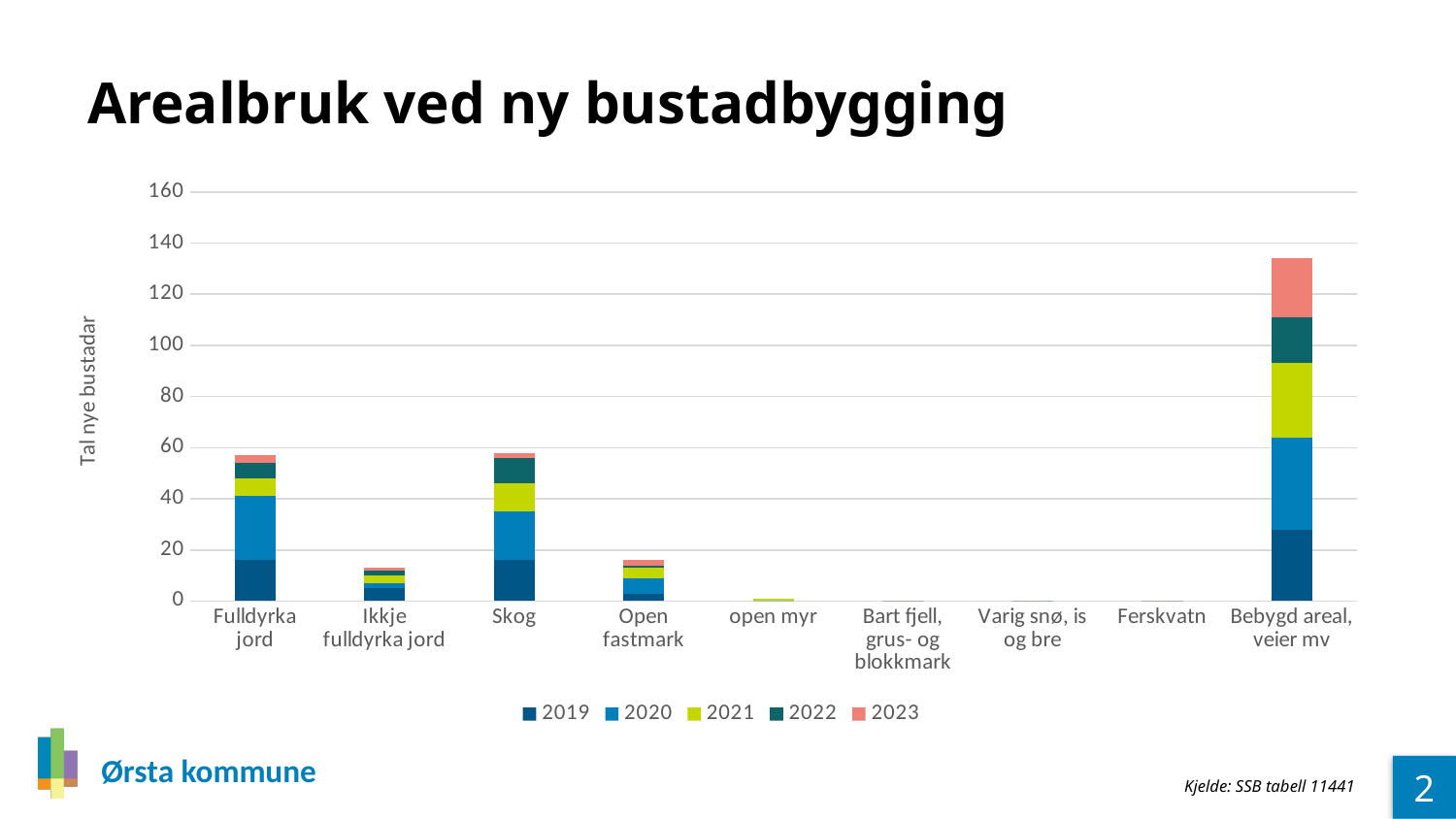
How many categories are shown on the x axis? 9 How many series does the legend list? 5 Is the total value for Skog greater or less than 40? greater What is the label on the vertical axis? Tal nye bustadar Is the total value for Ikkje fulldyrka jord greater or less than 20? less What kind of chart is shown on the slide? Stacked bar chart What is the title of the chart? Arealbruk ved ny bustadbygging Which has a larger total, Fulldyrka jord or Ikkje fulldyrka jord? Fulldyrka jord Is the total value for Open fastmark greater or less than 20? less Which category has the highest total number of new dwellings? Bebygd areal, veier mv